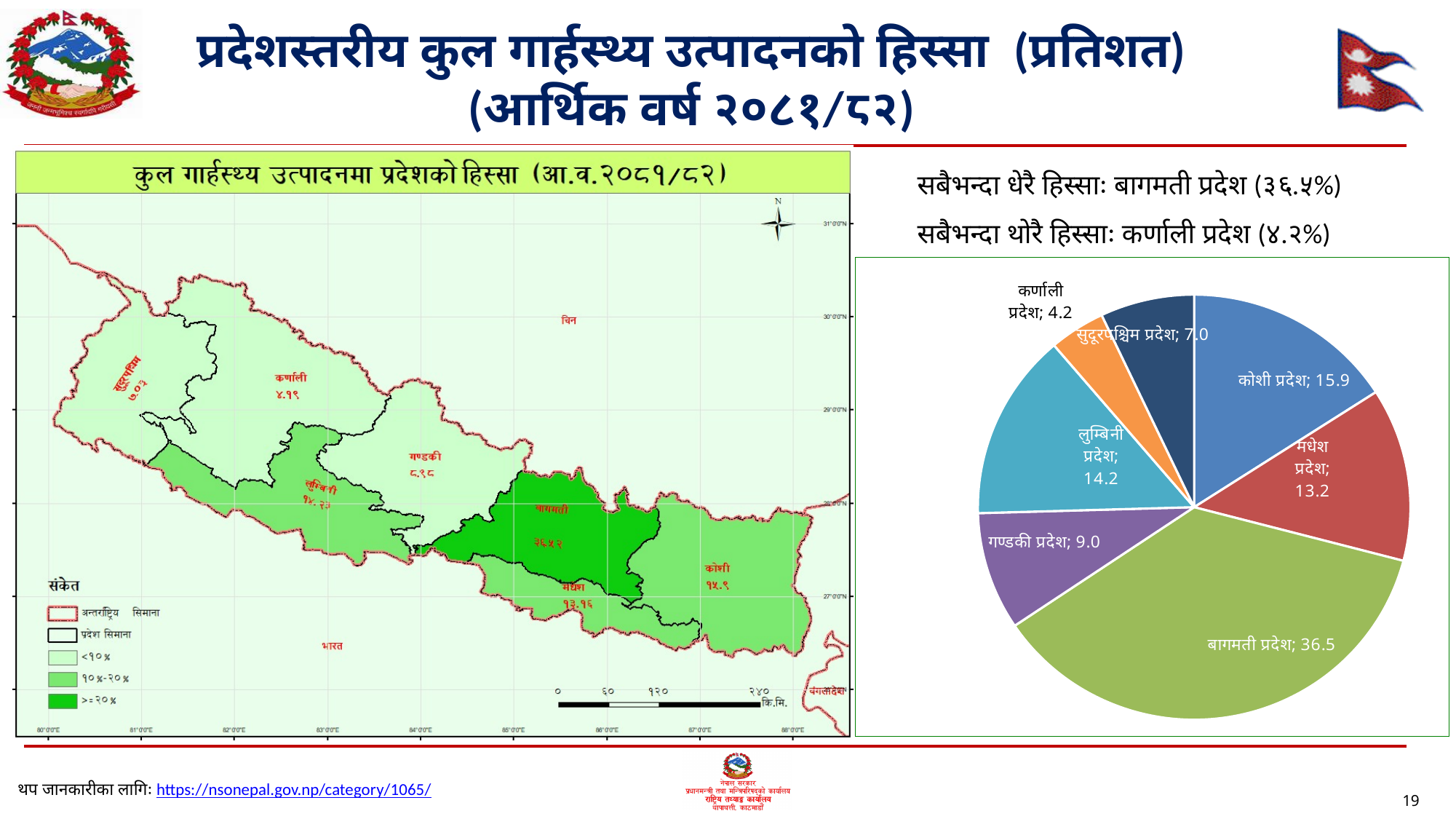
In the pie chart, what colour is the slice for बागमती प्रदेश? Green In the pie chart, what is the value shown for बागमती प्रदेश (Bagmati Province)? 36.5 How many slices does the pie chart have? 7 In the pie chart, what is the difference between the values for बागमती प्रदेश and कर्णाली प्रदेश? 32.3 In the pie chart, what is the difference between the values for कोशी प्रदेश and मधेश प्रदेश? 2.7 In the pie chart, what is the value shown for लुम्बिनी प्रदेश (Lumbini Province)? 14.2 In the pie chart, which province has the smallest slice? कर्णाली प्रदेश In the pie chart, what is the value shown for सुदूरपश्चिम प्रदेश (Sudurpashchim Province)? 7.0 In the pie chart, which province has the largest slice? बागमती प्रदेश In the pie chart, which is larger: the value for गण्डकी प्रदेश or the value for सुदूरपश्चिम प्रदेश? गण्डकी प्रदेश In the pie chart, what is the value shown for कोशी प्रदेश (Koshi Province)? 15.9 What type of chart is shown on the right side of the slide? Pie chart